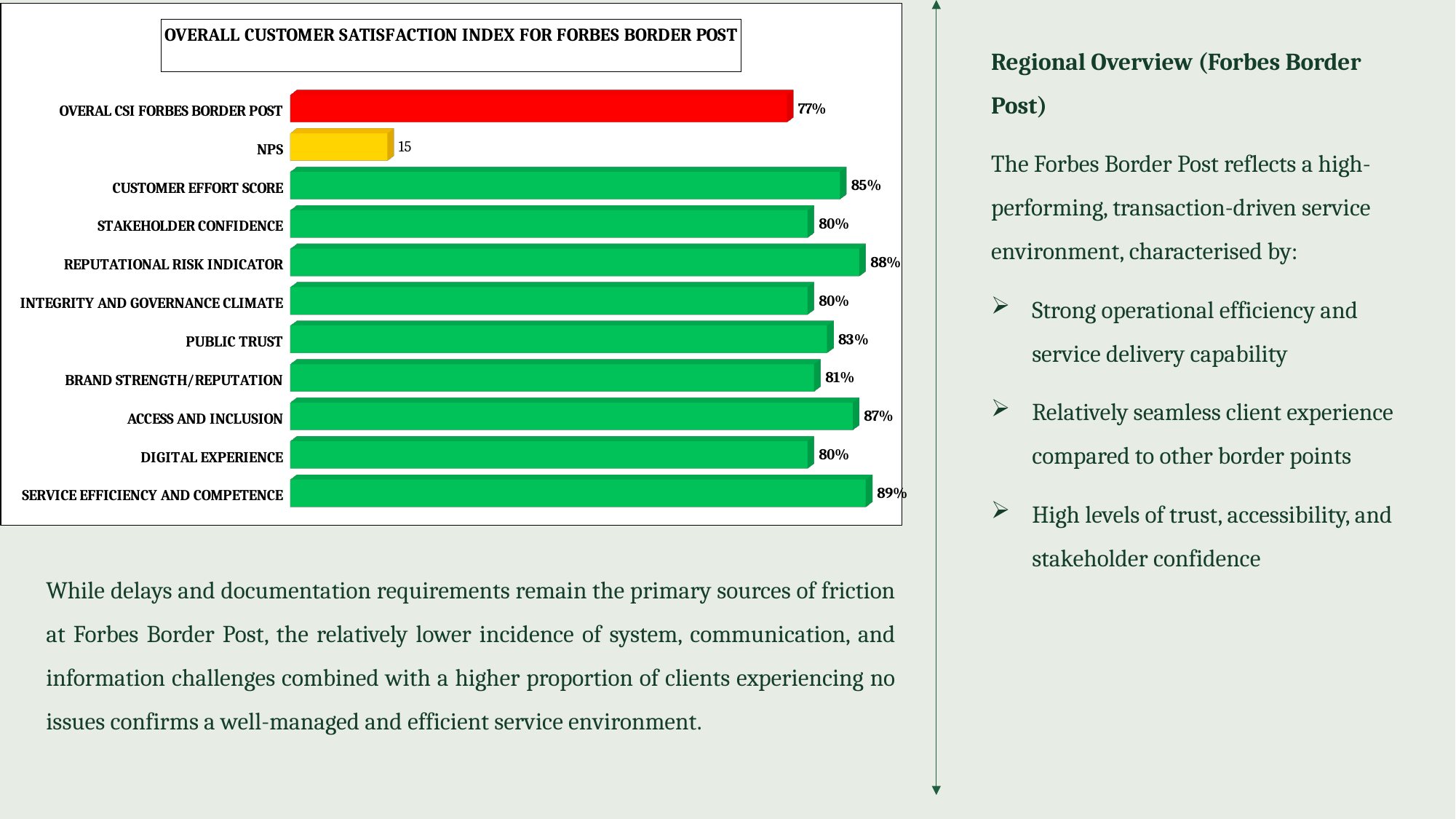
How many categories are shown in the chart? 11 What is the value for SERVICE EFFICIENCY AND COMPETENCE? 89% What is the value for OVERAL CSI FORBES BORDER POST? 77% What is the value for NPS? 15 Which is larger, PUBLIC TRUST or BRAND STRENGTH/REPUTATION? PUBLIC TRUST What colour is the bar for OVERAL CSI FORBES BORDER POST? Red What is the value for ACCESS AND INCLUSION? 87% What kind of chart is shown? Bar chart What is the difference between REPUTATIONAL RISK INDICATOR and STAKEHOLDER CONFIDENCE? 8% What is the title of the chart? OVERALL CUSTOMER SATISFACTION INDEX FOR FORBES BORDER POST Which category has the lowest value? NPS Which category has the highest value? SERVICE EFFICIENCY AND COMPETENCE